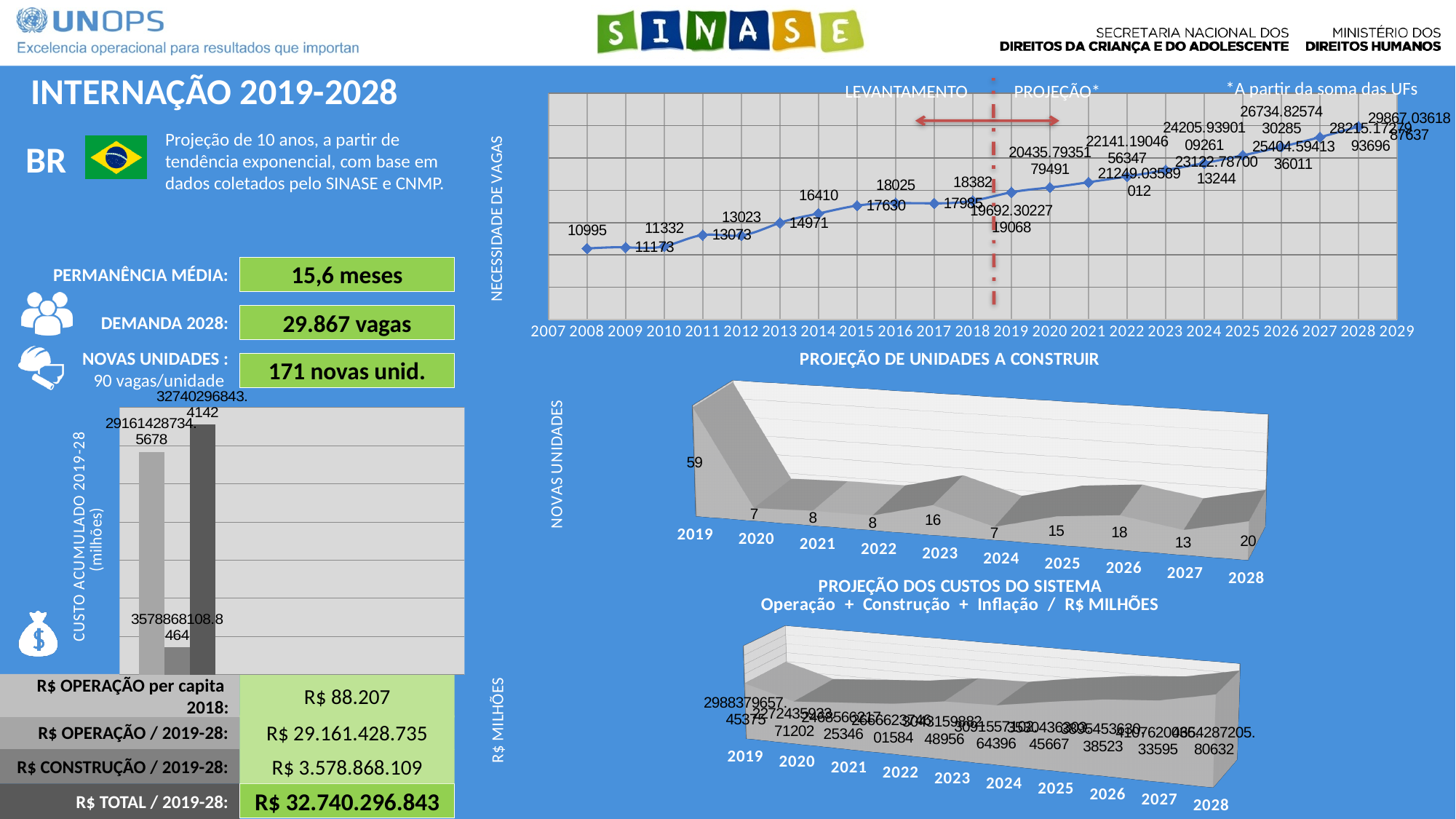
What kind of chart is the top-right chart labelled NECESSIDADE DE VAGAS? line chart In the chart titled PROJEÇÃO DE UNIDADES A CONSTRUIR, which year has the larger value, 2025 or 2026? 2026 In the chart titled PROJEÇÃO DE UNIDADES A CONSTRUIR, what is the value for 2028? 20 In the chart titled PROJEÇÃO DE UNIDADES A CONSTRUIR, what is the difference between the values for 2028 and 2027? 7 In the chart titled PROJEÇÃO DE UNIDADES A CONSTRUIR, how many years are shown on the x axis? 10 In the chart titled PROJEÇÃO DE UNIDADES A CONSTRUIR, what is the value for 2023? 16 In the top-right chart labelled NECESSIDADE DE VAGAS, what two labels appear on either side of the red dashed vertical line? LEVANTAMENTO and PROJEÇÃO In the chart titled PROJEÇÃO DE UNIDADES A CONSTRUIR, which year has the highest value? 2019 In the chart titled PROJEÇÃO DE UNIDADES A CONSTRUIR, what is the difference between the values for 2019 and 2020? 52 In the chart titled PROJEÇÃO DE UNIDADES A CONSTRUIR, what is the value for 2019? 59 In the top-right chart labelled NECESSIDADE DE VAGAS, do the values generally rise or fall from 2008 to 2028? rise How many bars are in the bottom-left chart labelled CUSTO ACUMULADO 2019-28 (milhões)? 3